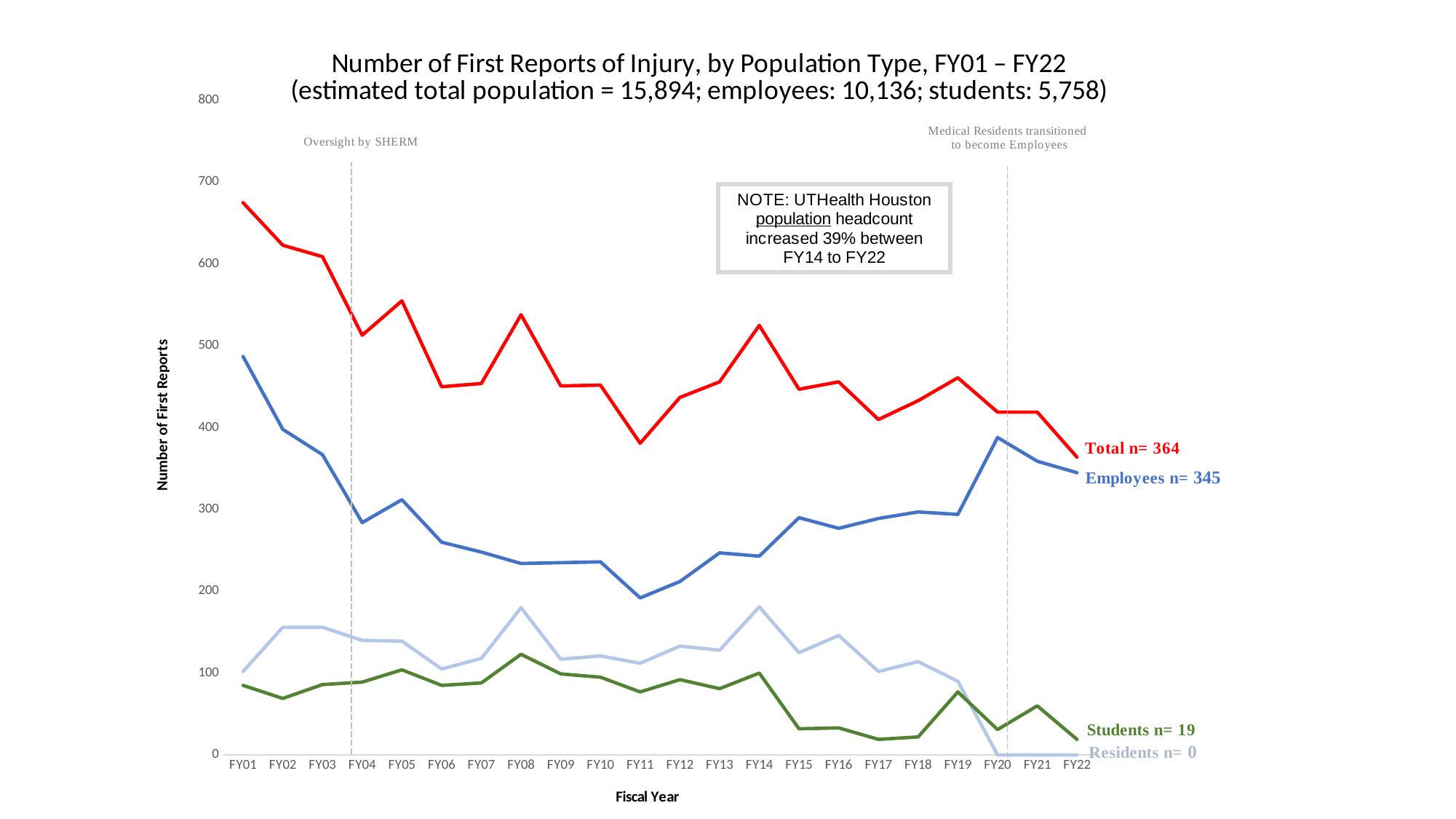
What is the difference between the Total and Employees values labelled at FY22? 19 Does the Total series overall rise or fall from FY01 to FY22? fall What kind of chart is shown on the slide? line chart What is the value labelled for the Students series at FY22? 19 How many fiscal years are shown on the x axis? 22 What is the value labelled for the Employees series at FY22? 345 Which series has the lowest value at FY22? Residents At FY22, which is larger: the Employees value or the Students value? Employees Is the Students value at FY17 greater or less than 100? less Is the Total value at FY01 greater or less than 600? greater What is the value labelled for the Total series at FY22? 364 What is the value labelled for the Residents series at FY22? 0